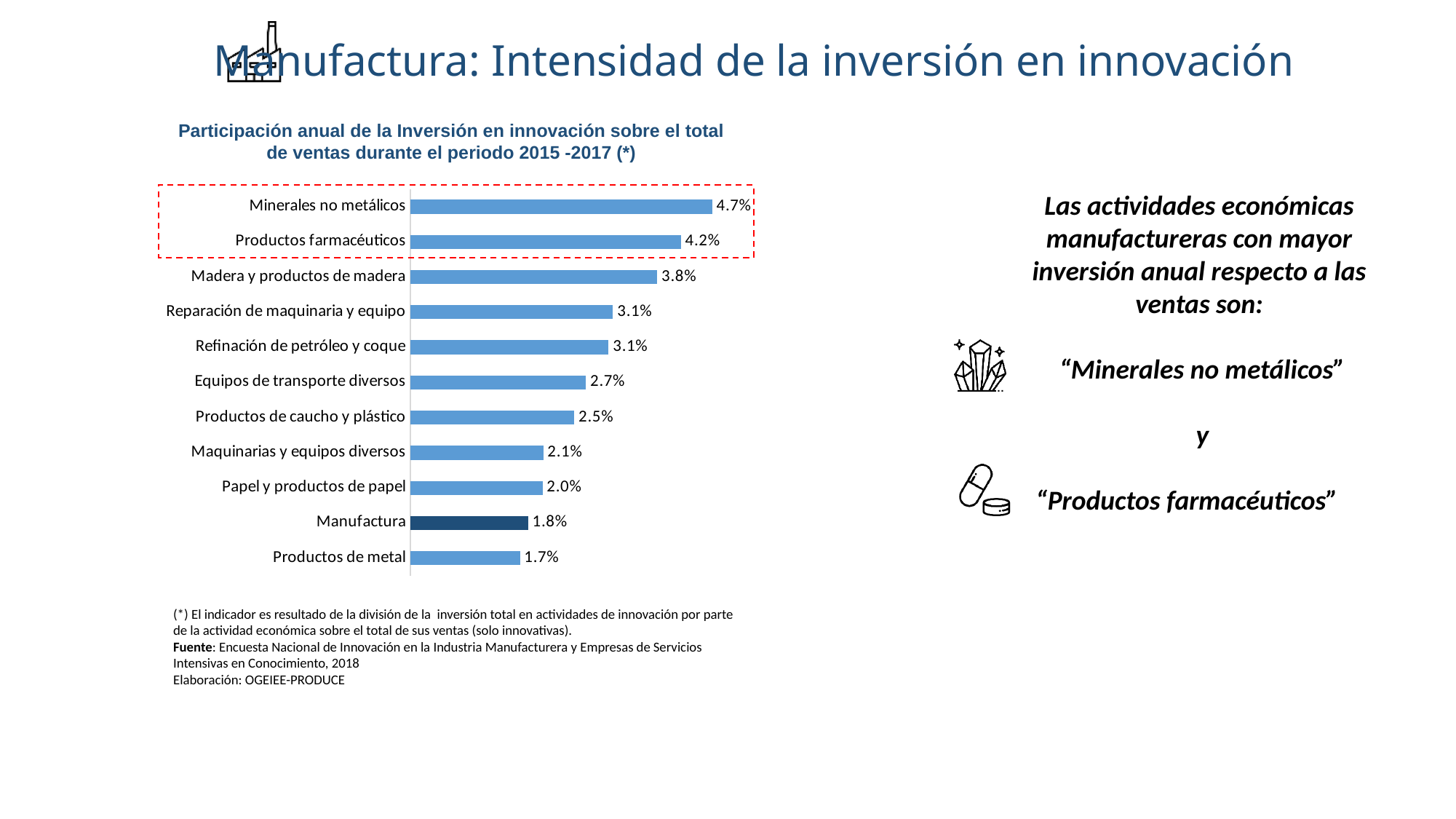
Which bar in the chart is drawn in a darker blue than the others? Manufactura What is the value for Minerales no metálicos? 4.7% Which category has the highest value? Minerales no metálicos What kind of chart is shown on the slide? Bar chart What is the difference between the values for Madera y productos de madera and Manufactura? 2.0% What is the value for Manufactura? 1.8% Which category has the lowest value? Productos de metal How many categories are shown in the chart? 11 What is the difference between the values for Minerales no metálicos and Productos farmacéuticos? 0.5% Which is larger, the value for Equipos de transporte diversos or the value for Productos de caucho y plástico? Equipos de transporte diversos What is the value for Papel y productos de papel? 2.0% What is the value for Productos farmacéuticos? 4.2%